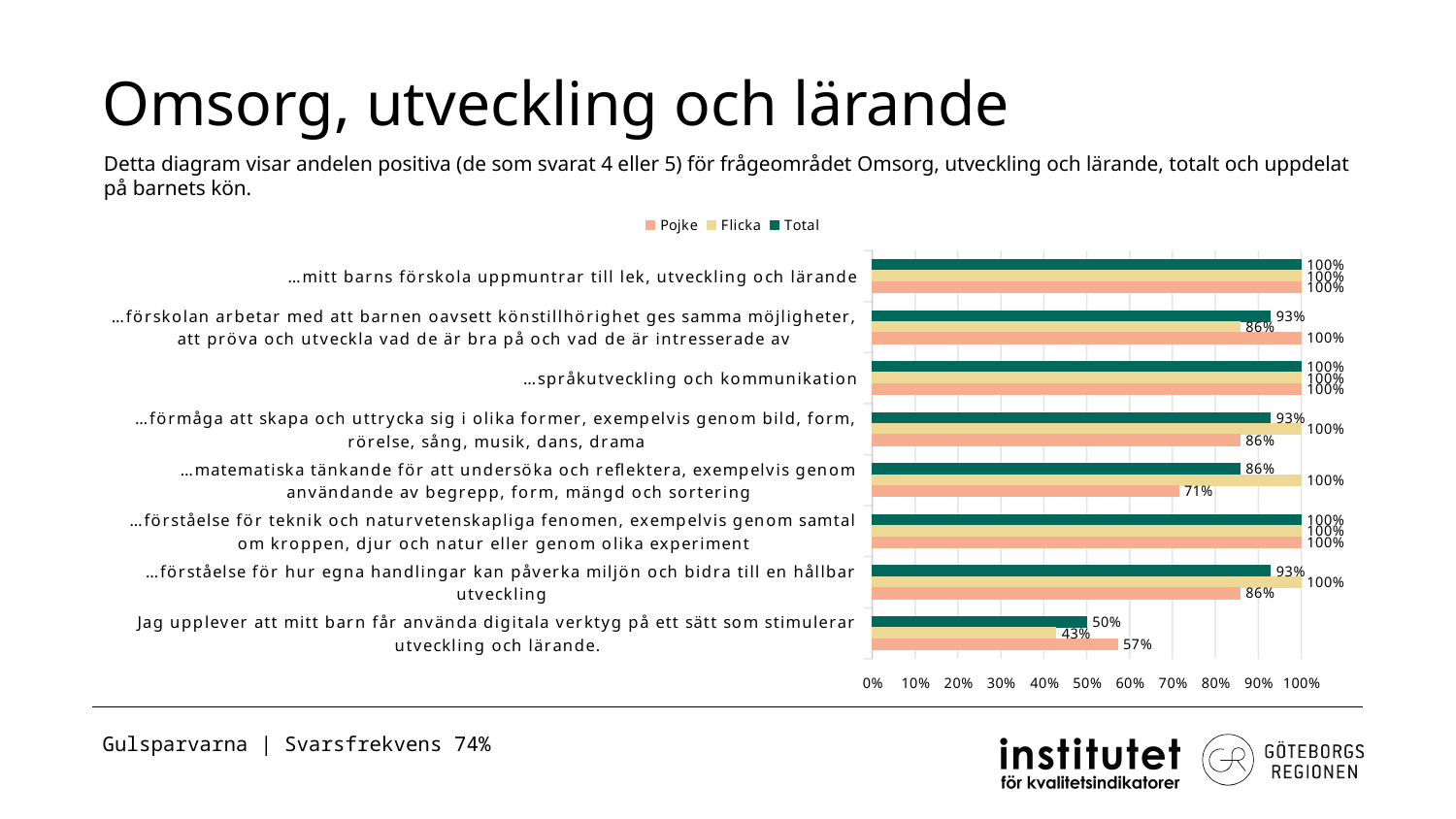
How many categories (statements) are plotted in the chart? 8 What is the Total value for "…förståelse för hur egna handlingar kan påverka miljön och bidra till en hållbar utveckling"? 93% What type of chart is shown on the slide? bar chart What is the Total value for "Jag upplever att mitt barn får använda digitala verktyg på ett sätt som stimulerar utveckling och lärande."? 50% Which category has the lowest Total value? Jag upplever att mitt barn får använda digitala verktyg på ett sätt som stimulerar utveckling och lärande. What is the Flicka value for "…förskolan arbetar med att barnen oavsett könstillhörighet ges samma möjligheter, att pröva och utveckla vad de är bra på och vad de är intresserade av"? 86% For "Jag upplever att mitt barn får använda digitala verktyg på ett sätt som stimulerar utveckling och lärande.", which is larger, the Pojke value or the Flicka value? Pojke What is the difference between the Pojke and Flicka values for "Jag upplever att mitt barn får använda digitala verktyg på ett sätt som stimulerar utveckling och lärande."? 14% How many series does the legend list? 3 Which series is shown in dark green in the chart? Total What is the difference between the Flicka and Pojke values for "…matematiska tänkande för att undersöka och reflektera, exempelvis genom användande av begrepp, form, mängd och sortering"? 29% What is the Pojke value for "…matematiska tänkande för att undersöka och reflektera, exempelvis genom användande av begrepp, form, mängd och sortering"? 71%